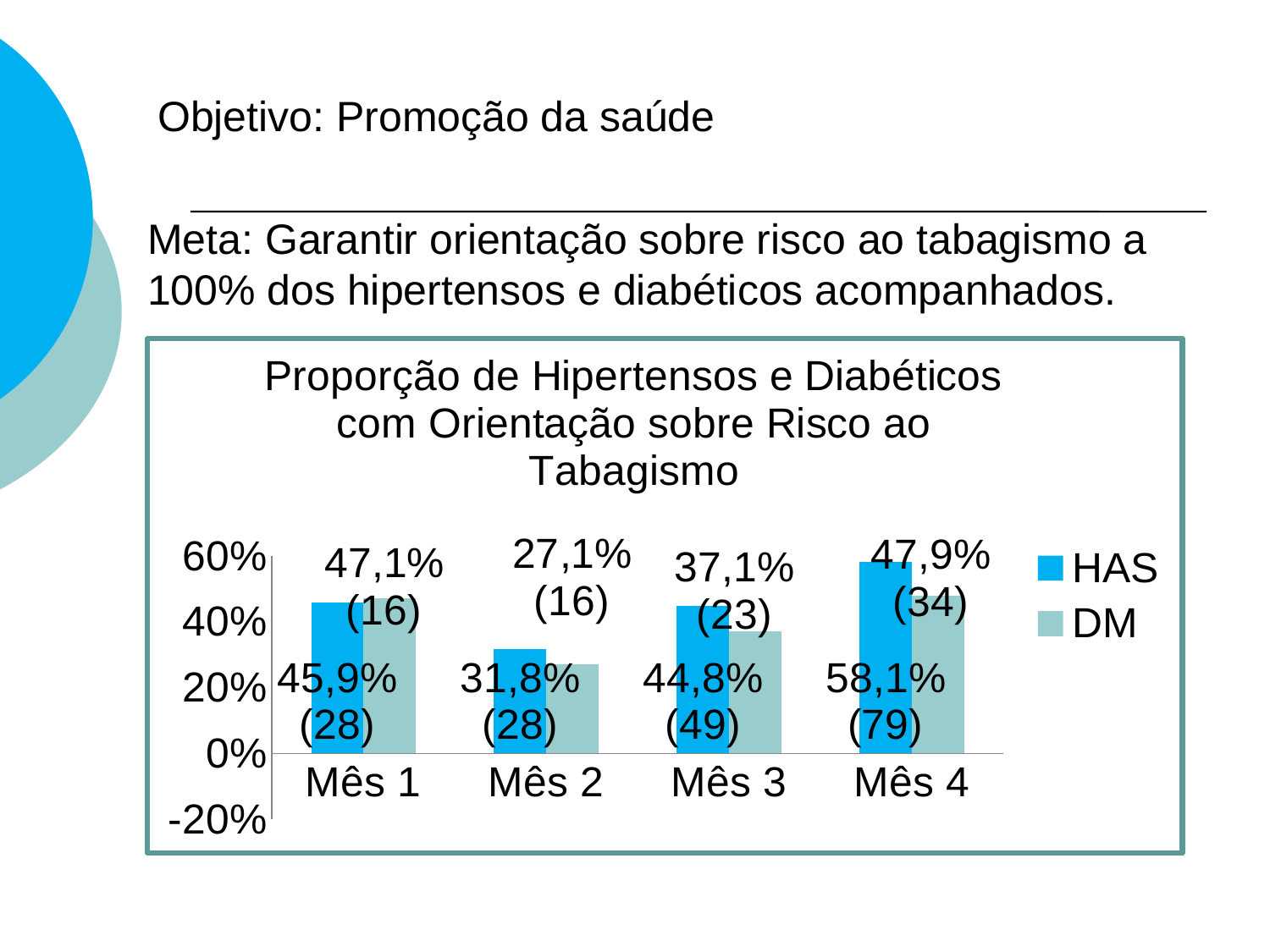
What is the title of the chart? Proporção de Hipertensos e Diabéticos com Orientação sobre Risco ao Tabagismo Which is larger in Mês 3, the HAS value or the DM value? HAS How many months are shown on the x axis? 4 What is the DM value for Mês 2? 27,1% What is the HAS value for Mês 1? 45,9% In which month is the DM value lowest? Mês 2 How many series does the legend list? 2 What is the HAS value for Mês 4? 58,1% What kind of chart is shown on the slide? Bar chart In which month is the HAS value highest? Mês 4 What is the DM value for Mês 3? 37,1% What is the difference between the HAS value for Mês 4 and the HAS value for Mês 2? 26,3%